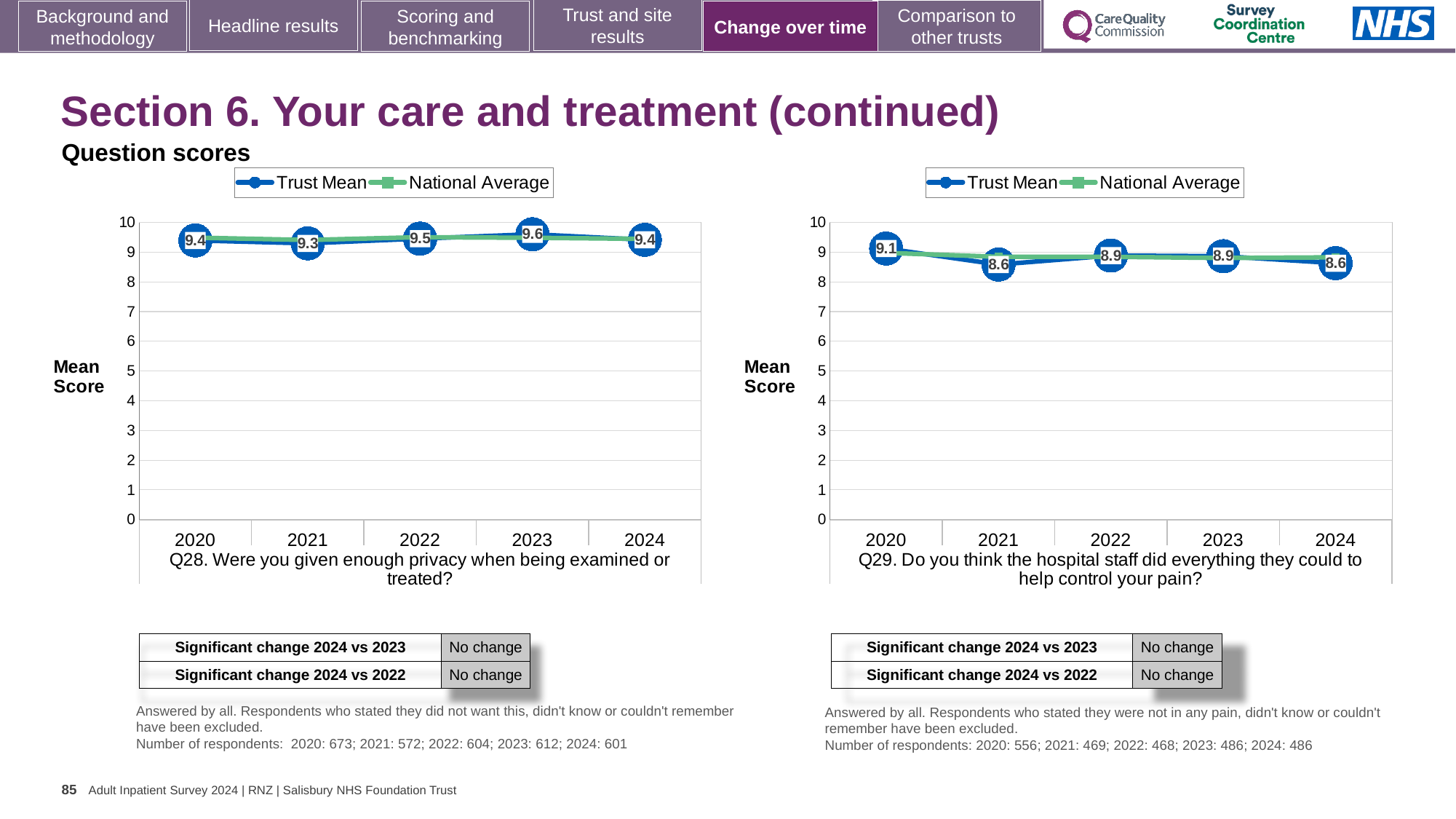
In the Q28 chart (left), what is the Trust Mean score for 2023? 9.6 In the Q29 chart (right), what is the difference between the Trust Mean scores for 2020 and 2021? 0.5 In the Q28 chart (left), what is the Trust Mean score for 2021? 9.3 How many series does the legend of the Q29 chart (right) list? 2 In the Q29 chart (right), is the Trust Mean score for 2022 higher or lower than for 2024? higher In the Q29 chart (right), what is the Trust Mean score for 2020? 9.1 In the Q28 chart (left), what is the difference between the Trust Mean scores for 2023 and 2021? 0.3 In the Q29 chart (right), what is the Trust Mean score for 2024? 8.6 What type of chart is the Q28 chart (left)? Line chart How many years are plotted on the x axis of the Q28 chart (left)? 5 In the Q28 chart (left), which year has the highest Trust Mean score? 2023 In the Q29 chart (right), which year has the highest Trust Mean score? 2020